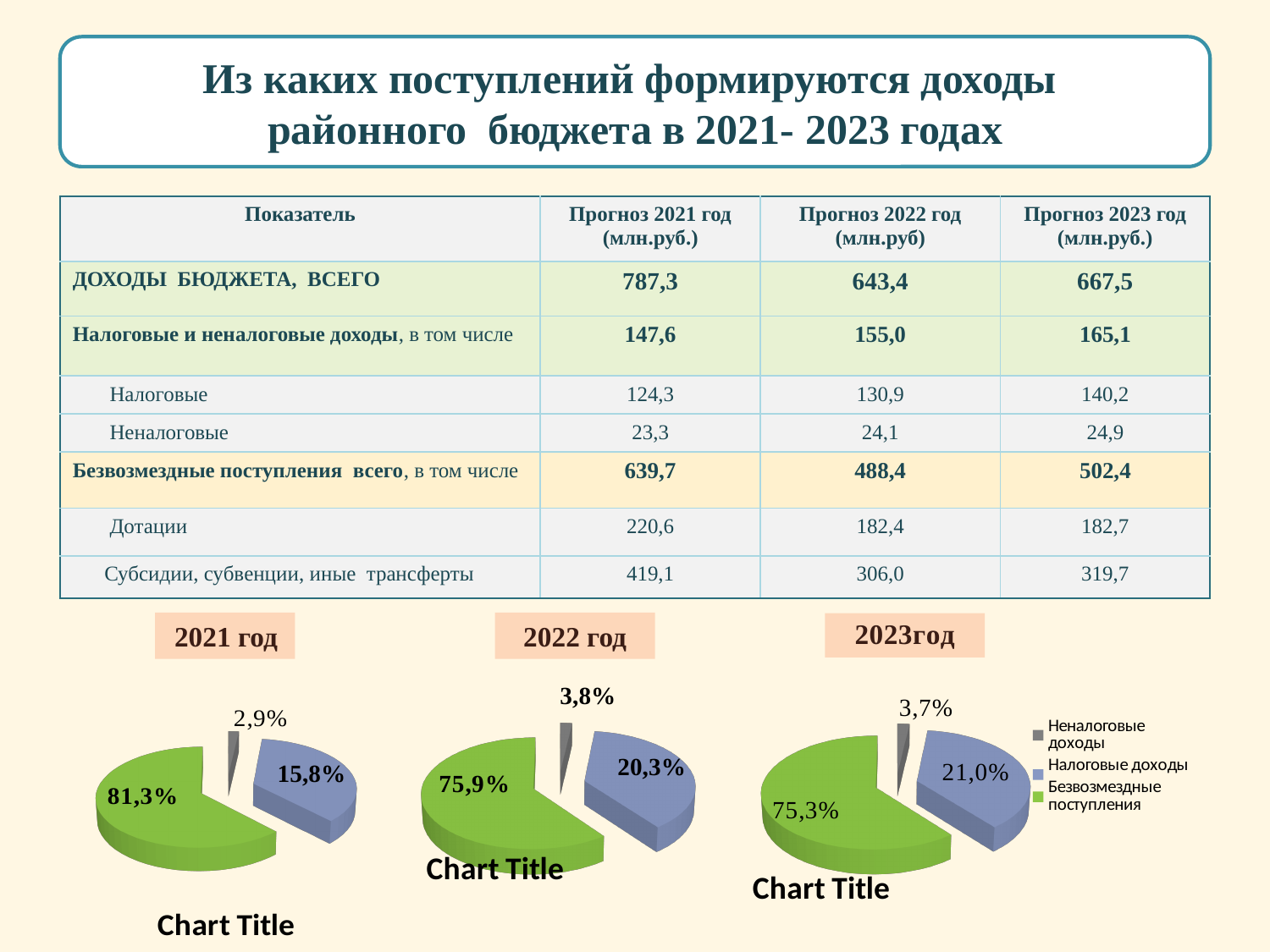
What type of chart is used for the 2021 год, 2022 год and 2023 год data? Pie chart In the 2021 год pie chart, what share is shown for Налоговые доходы (blue slice)? 15,8% In the 2023 год pie chart, what share is shown for Безвозмездные поступления (green slice)? 75,3% In the 2021 год pie chart, what share is shown for Безвозмездные поступления (green slice)? 81,3% How many entries does the legend next to the 2023 год chart list? 3 In the 2022 год pie chart, which category has the largest slice? Безвозмездные поступления In the 2023 год pie chart, what share is shown for Налоговые доходы (blue slice)? 21,0% In the 2021 год pie chart, which category has the smallest slice? Неналоговые доходы How many slices does the 2023 год pie chart have? 3 In the 2022 год pie chart, what is the difference between the shares of Безвозмездные поступления and Налоговые доходы? 55,6% In the 2022 год pie chart, what share is shown for Неналоговые доходы (grey slice)? 3,8% Which is larger: the share of Налоговые доходы in the 2021 год chart or in the 2023 год chart? 2023 год